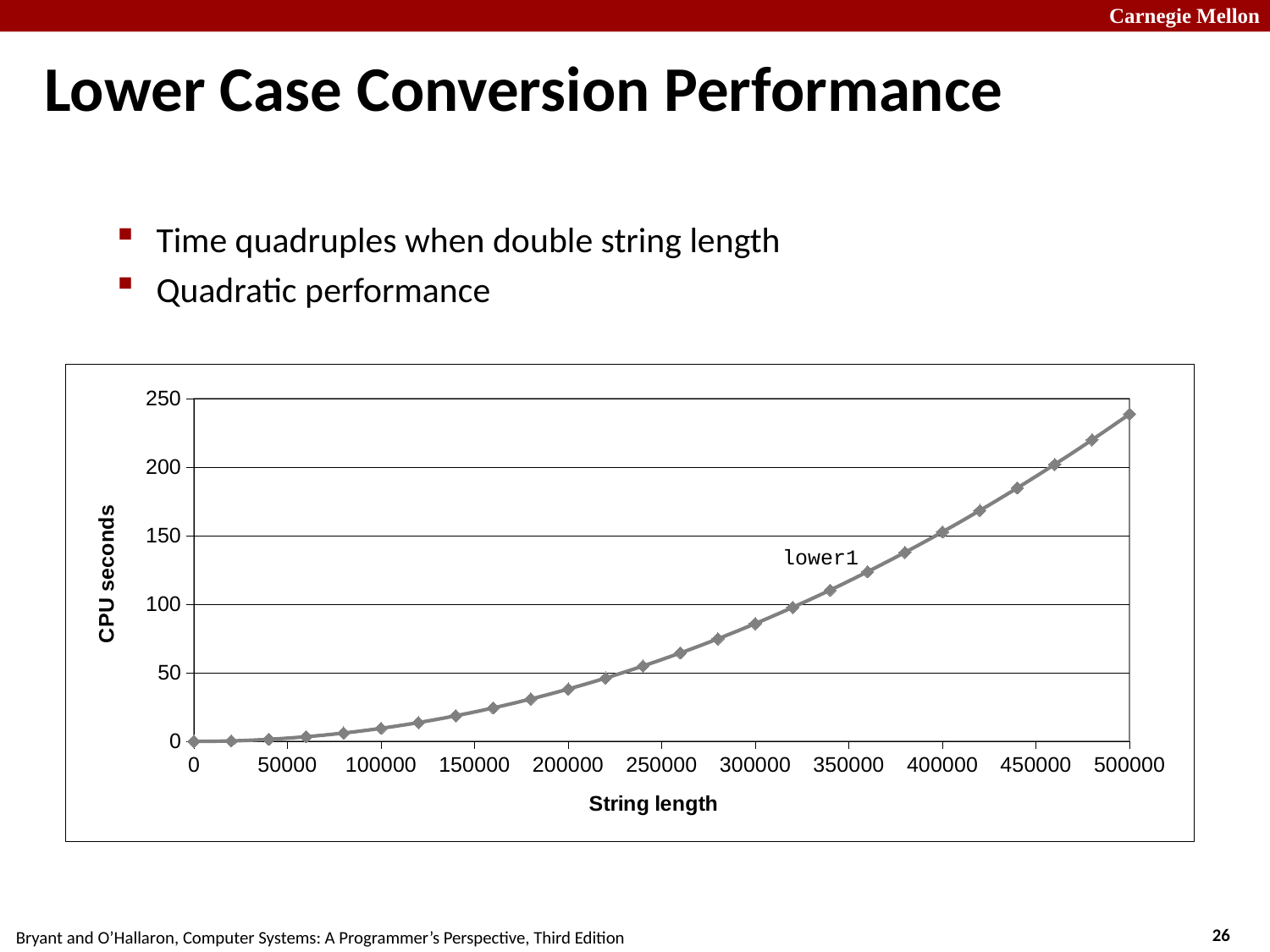
Is the value for string length 300000 greater or less than 100? less What kind of chart is shown on the slide? line chart What is the label of the series plotted in the chart? lower1 Which has the larger CPU time, string length 100000 or string length 400000? 400000 Is the value for string length 200000 greater or less than 50? less Do the CPU seconds rise or fall as string length increases? rise At which string length is the CPU time lowest? 0 How many tick labels are shown on the x axis? 11 Is the value for string length 500000 greater or less than 200? greater What is the title of the y axis? CPU seconds How many series are plotted in the chart? 1 At which string length is the CPU time highest? 500000